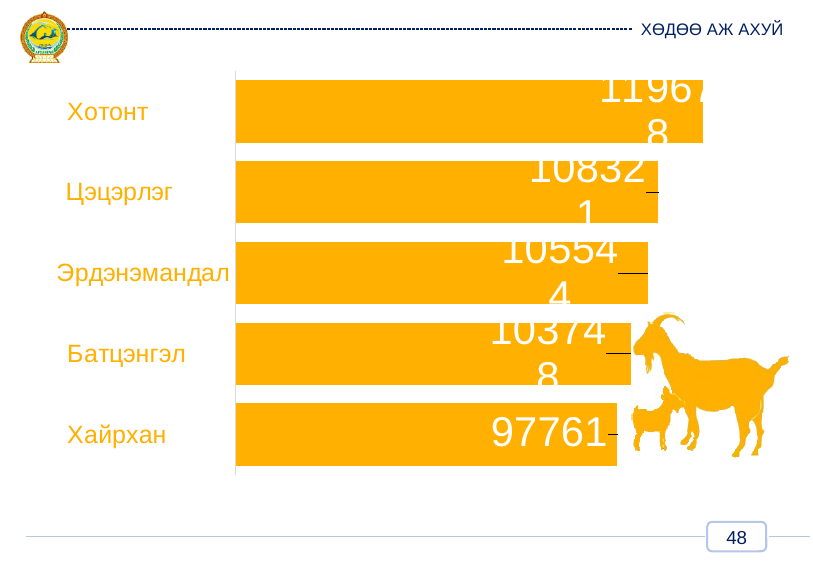
What is the difference between the values for Эрдэнэмандал and Батцэнгэл? 1796 What is the value for Хайрхан? 97761 What is the value for Эрдэнэмандал? 105544 What is the difference between the values for Цэцэрлэг and Хайрхан? 10560 Which category has the highest value? Хотонт What is the value for Цэцэрлэг? 108321 Which category has the lowest value? Хайрхан What is the value for Батцэнгэл? 103748 Do the values increase or decrease going from the top bar to the bottom bar? decrease Which is larger, the value for Батцэнгэл or the value for Хайрхан? Батцэнгэл How many categories are shown in the chart? 5 What kind of chart is shown on the slide? bar chart